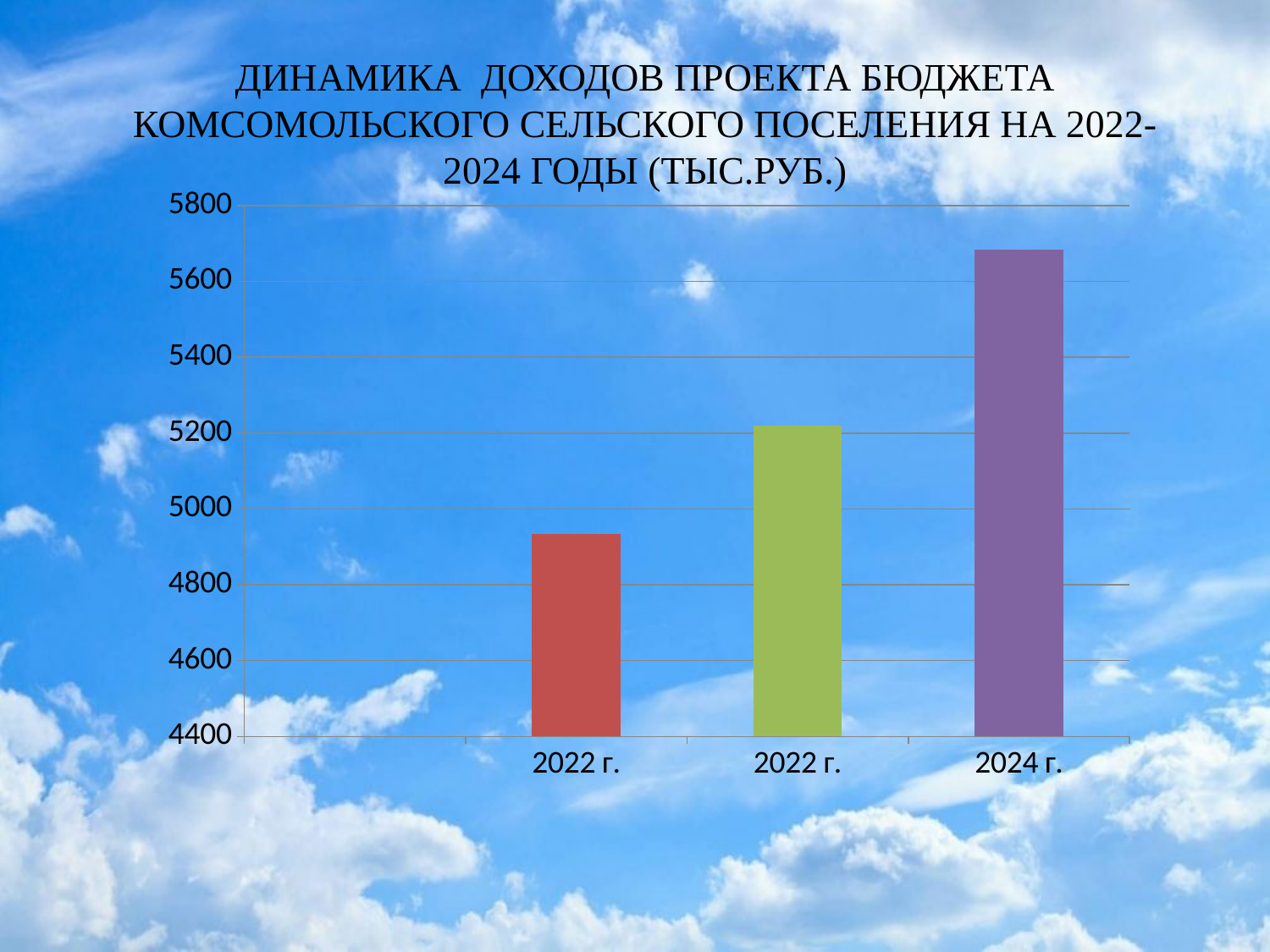
Is the value for 2024 г. greater or less than 5600? greater Is the value of the middle (green) bar greater or less than 5000? greater Do the values rise or fall from left to right along the x axis? rise Which is larger, the value for 2024 г. or the value of the leftmost (red) bar? 2024 г. How many bars are plotted in the chart? 3 Which bar is the lowest in the chart? the leftmost (red) bar, 2022 г. Which is larger, the middle (green) bar or the leftmost (red) bar? the middle (green) bar Which category has the highest bar? 2024 г. What colour is the bar for 2024 г.? purple Is the value for 2024 г. greater or less than 5800? less What kind of chart is shown on the slide? bar chart